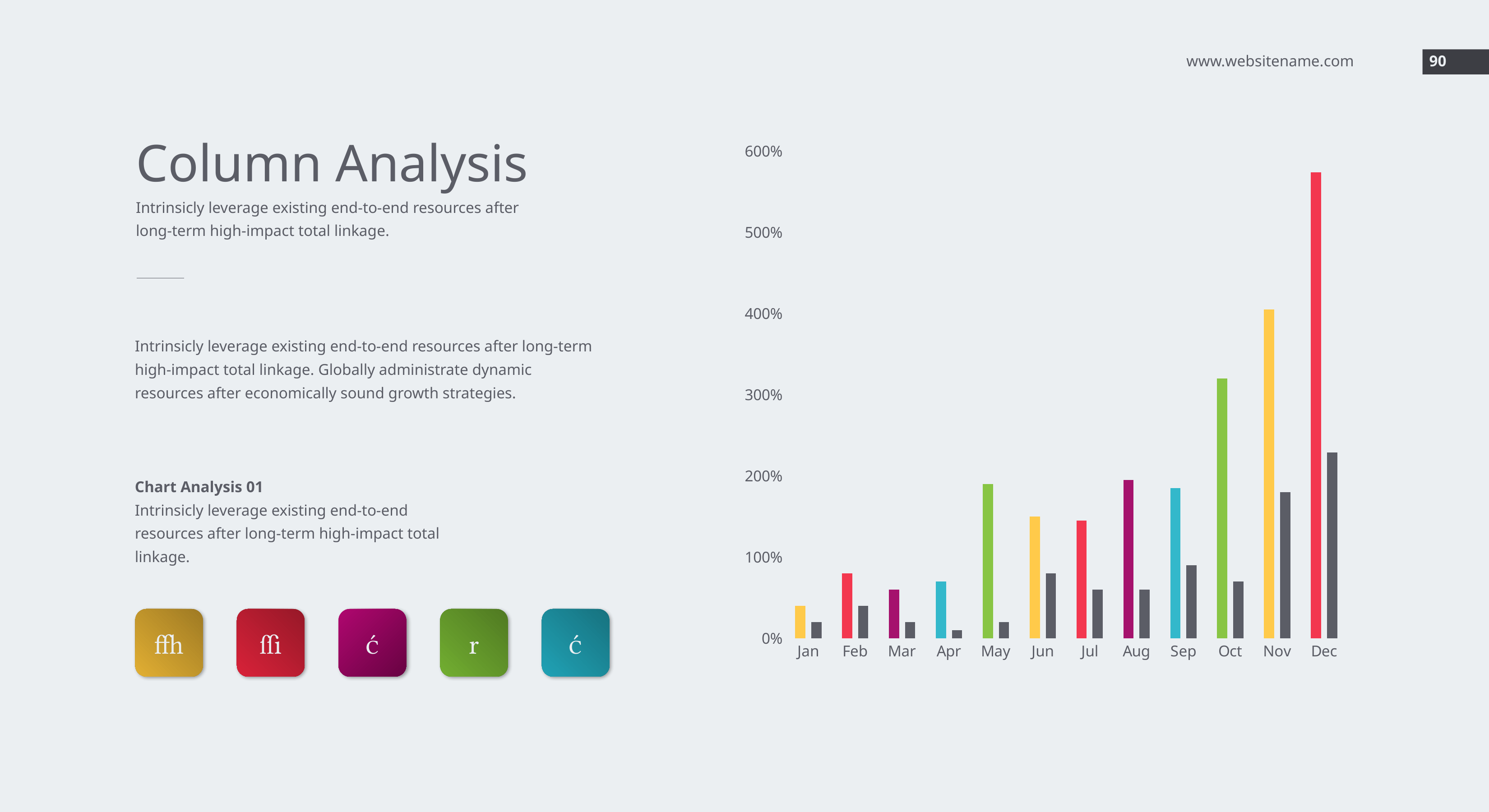
Which month has the tallest bar in the chart? Dec Which is larger, the coloured bar for Oct or the coloured bar for Nov? Nov Is the value of the coloured bar for Dec greater or less than 500%? greater Which is larger, the coloured bar for May or the coloured bar for Jun? May Is the value of the grey bar for Dec greater or less than 200%? greater How many months are shown on the x axis of the chart? 12 What kind of chart is shown on the slide? bar chart Is the value of the coloured bar for Jan greater or less than 100%? less Do the coloured bars generally rise or fall from Jan to Dec? rise Which month has the shortest coloured (non-grey) bar in the chart? Jan